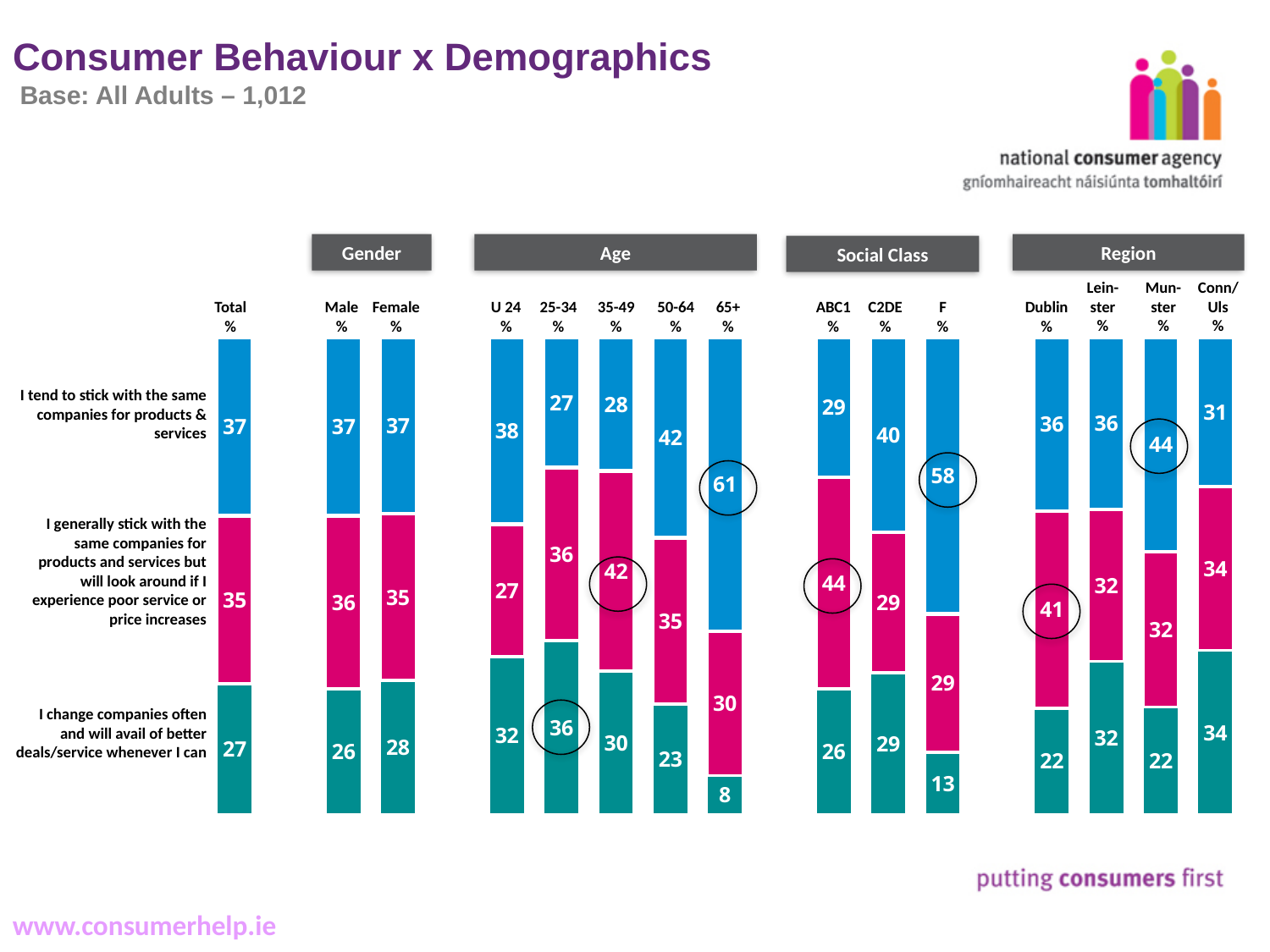
Among the age groups, which has the highest value for 'I change companies often and will avail of better deals/service whenever I can'? 25-34 What is the value for Dublin for 'I generally stick with the same companies for products and services but will look around if I experience poor service or price increases'? 41 How many demographic groups are shown under the Age heading? 5 What is the Total value for 'I change companies often and will avail of better deals/service whenever I can'? 27 Which region has the highest value for 'I tend to stick with the same companies for products & services'? Munster Among the age groups, which has the lowest value for 'I change companies often and will avail of better deals/service whenever I can'? 65+ What percentage of the 65+ age group say they tend to stick with the same companies for products and services? 61 What is the difference between the ABC1 and C2DE values for 'I generally stick with the same companies for products and services but will look around if I experience poor service or price increases'? 15 What kind of chart is shown on the slide? Stacked bar chart Which is larger for 'I change companies often and will avail of better deals/service whenever I can': Male or Female? Female What is the difference between the 65+ and U 24 values for 'I tend to stick with the same companies for products & services'? 23 Among the social class groups, which has the highest value for 'I tend to stick with the same companies for products & services'? F